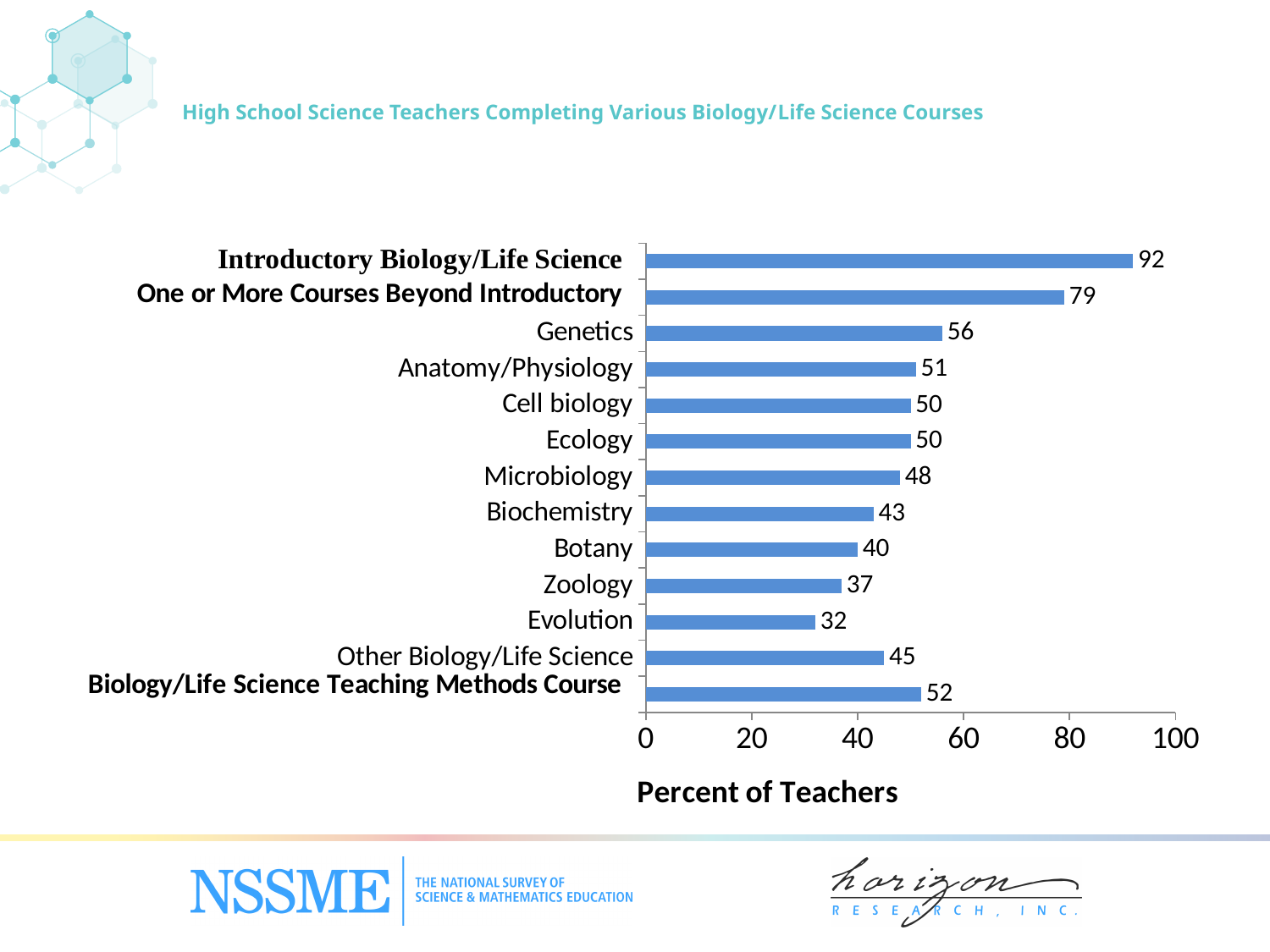
Which is larger, the value for Microbiology or the value for Biochemistry? Microbiology Which category has the highest value? Introductory Biology/Life Science What percent of teachers completed a Biology/Life Science Teaching Methods Course? 52 What is the difference between the values for Introductory Biology/Life Science and One or More Courses Beyond Introductory? 13 How many categories are shown in the chart? 13 What percent of teachers completed Genetics? 56 What is the difference between the values for Botany and Zoology? 3 Which category has the lowest value? Evolution What is the label of the horizontal axis? Percent of Teachers What kind of chart is shown on the slide? bar chart Is the value for Other Biology/Life Science greater or less than 40? greater What is the value for Evolution? 32